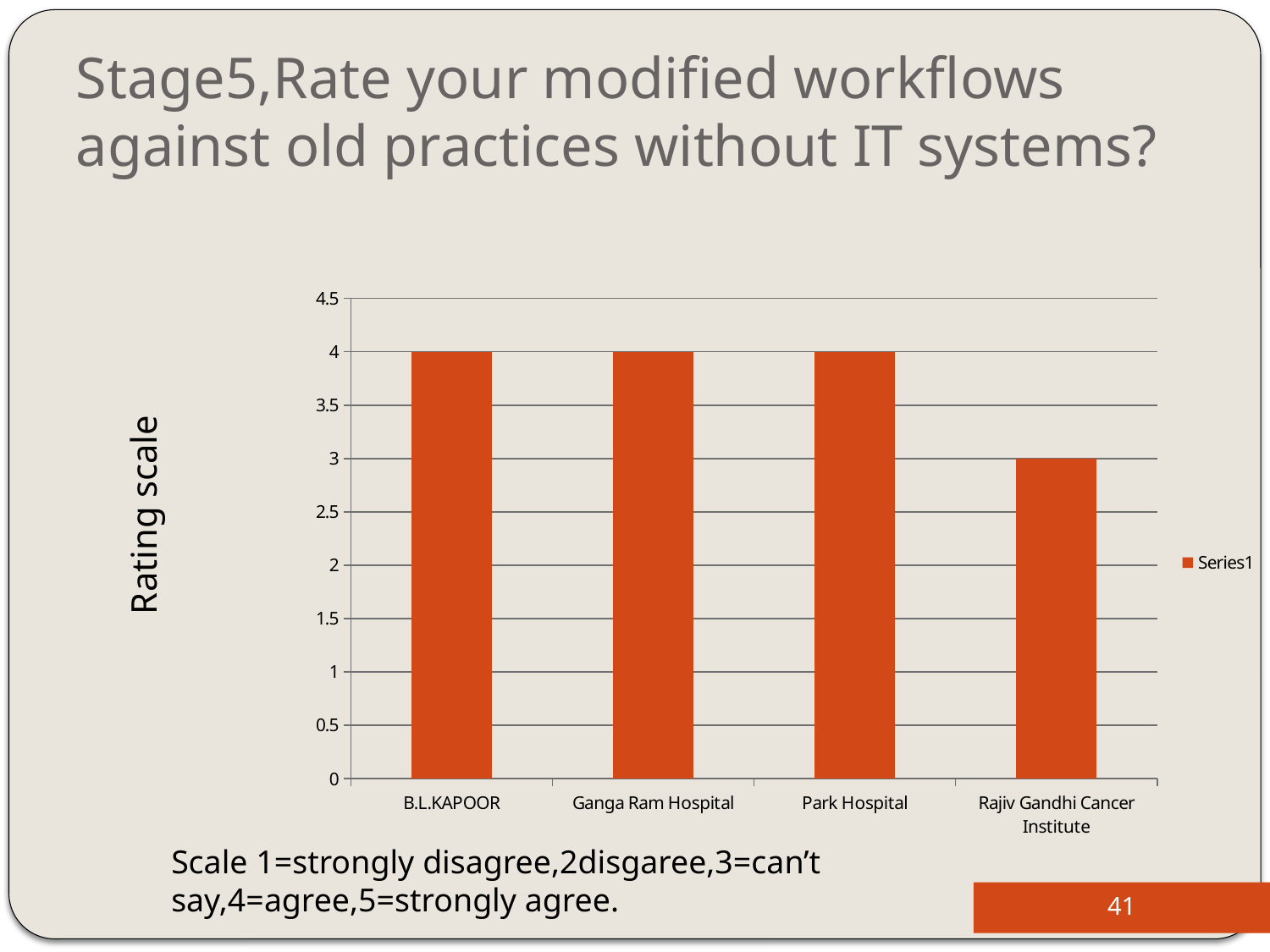
What is the difference between the rating for Ganga Ram Hospital and the rating for Rajiv Gandhi Cancer Institute? 1 Is the value for Rajiv Gandhi Cancer Institute greater or less than 3.5? less What is the name of the series shown in the chart legend? Series1 What is the rating for B.L.KAPOOR? 4 Which hospital has the lowest rating? Rajiv Gandhi Cancer Institute How many series does the chart legend list? 1 Which has a higher rating, Park Hospital or Rajiv Gandhi Cancer Institute? Park Hospital What is the rating for Park Hospital? 4 How many hospitals are shown on the x axis of the chart? 4 What is the label on the vertical axis of the chart? Rating scale What is the rating for Rajiv Gandhi Cancer Institute? 3 What type of chart is shown on the slide? bar chart